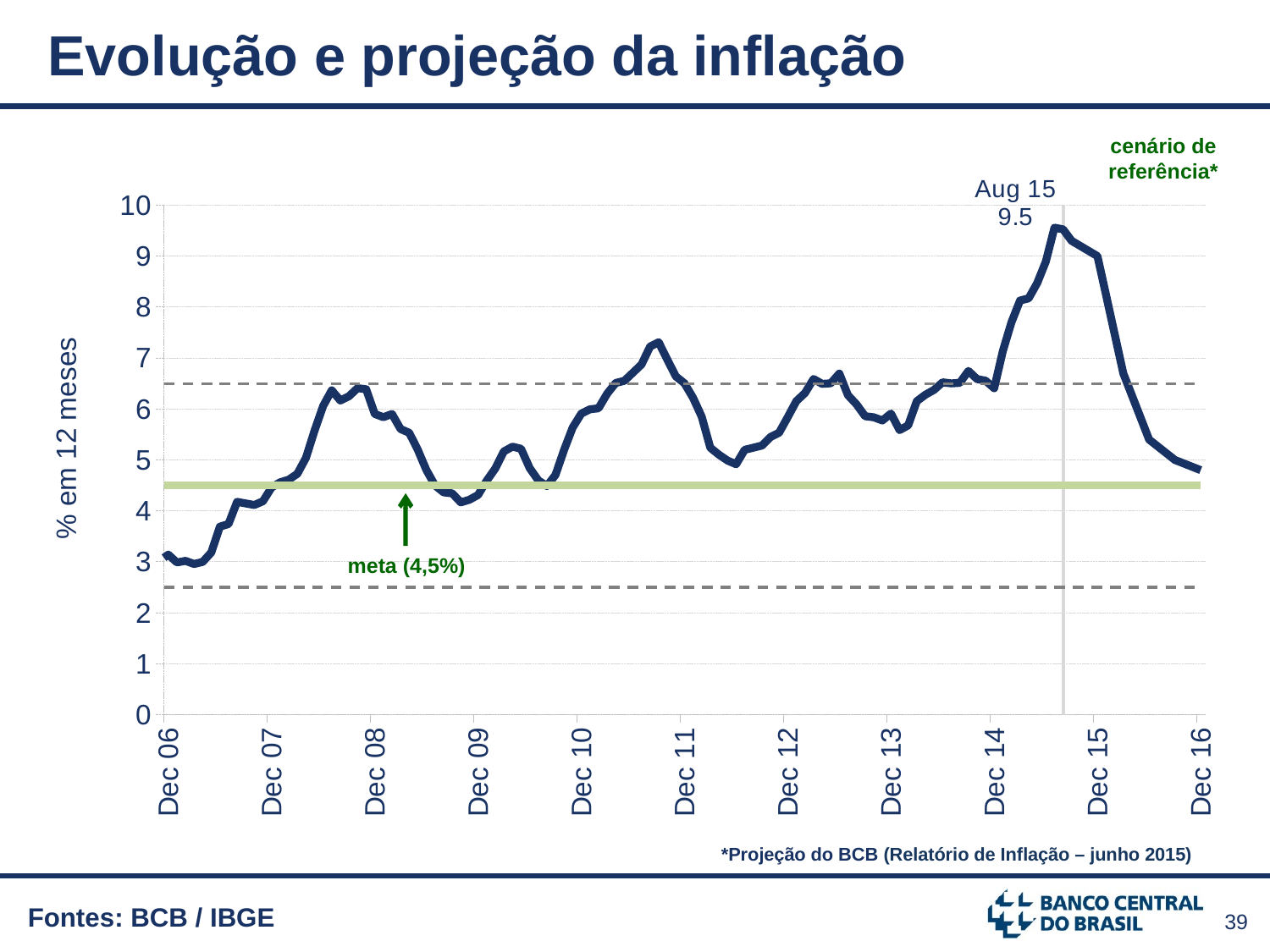
What inflation target (meta) is marked on the chart? 4,5% How many year labels are shown on the x axis? 11 Is the value at Dec 14 greater or less than 6? greater What is the inflation value labeled at Aug 15? 9.5 Does the line rise or fall between Aug 15 and Dec 16? fall Is the value at Dec 16 greater or less than 6? less At which labeled point does the line reach its highest value? Aug 15 Is the value at Dec 10 greater or less than 5? greater Which is larger, the value at Aug 15 or the value at Dec 16? Aug 15 What kind of chart is shown on the slide? line chart